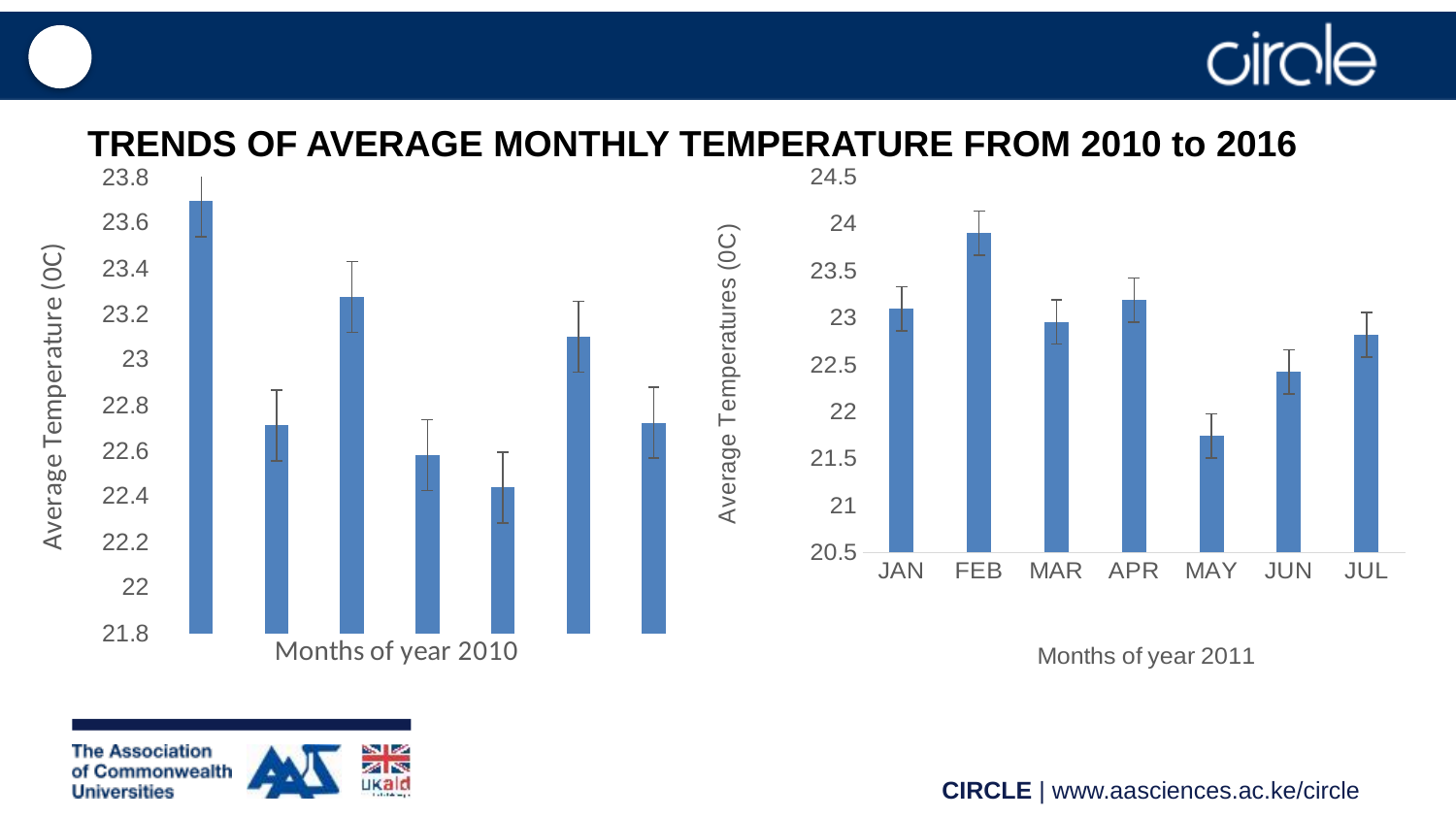
What kind of chart is the chart for Months of year 2010? Bar chart In the chart for Months of year 2011, which month has the lowest average temperature? MAY In the chart for Months of year 2011, is the value for MAY greater or less than 22? less In the chart for Months of year 2011, which is larger, the value for APR or the value for JUN? APR In the chart for Months of year 2011, is the value for JUL greater or less than 23? less In the chart for Months of year 2011, which is larger, the value for FEB or the value for MAY? FEB In the chart for Months of year 2011, is the value for FEB greater or less than 23.5? greater In the chart for Months of year 2011, which month has the highest average temperature? FEB What is the y-axis title of the chart for Months of year 2011? Average Temperatures (0C) How many months are shown in the chart for Months of year 2011? 7 How many bars are shown in the chart for Months of year 2010? 7